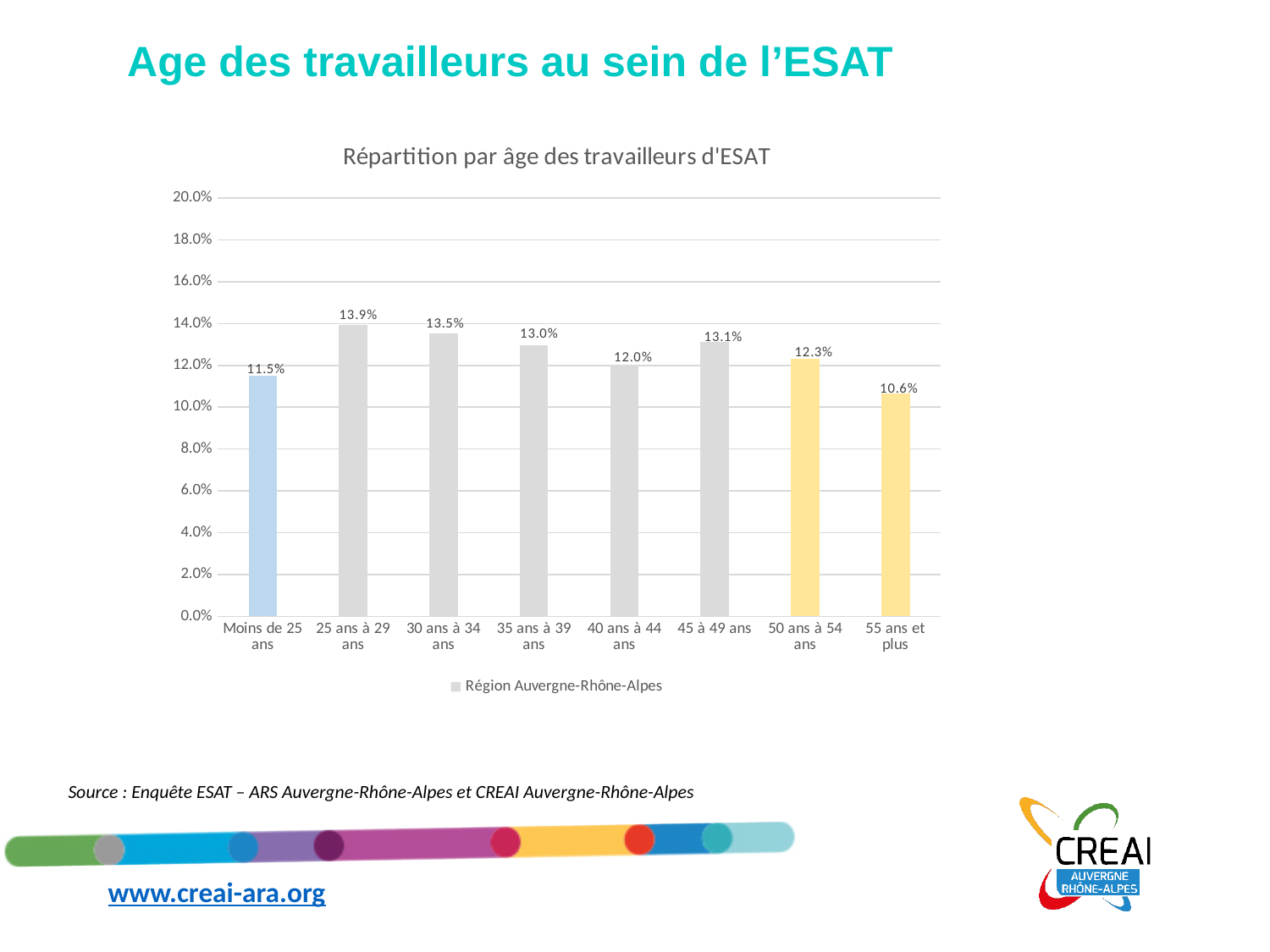
Which age category has the highest value? 25 ans à 29 ans What is the value for the '55 ans et plus' category? 10.6% Which age category has the lowest value? 55 ans et plus How many series does the legend list? 1 What is the value for the '25 ans à 29 ans' category? 13.9% What kind of chart is shown on the slide? bar chart What is the title of the chart? Répartition par âge des travailleurs d'ESAT What is the value for the 'Moins de 25 ans' category? 11.5% Which is larger, the value for '50 ans à 54 ans' or the value for '40 ans à 44 ans'? 50 ans à 54 ans How many age categories are shown on the x axis? 8 What is the difference between the values for '30 ans à 34 ans' and '40 ans à 44 ans'? 1.5% Is the value for '35 ans à 39 ans' greater or less than 14.0%? less